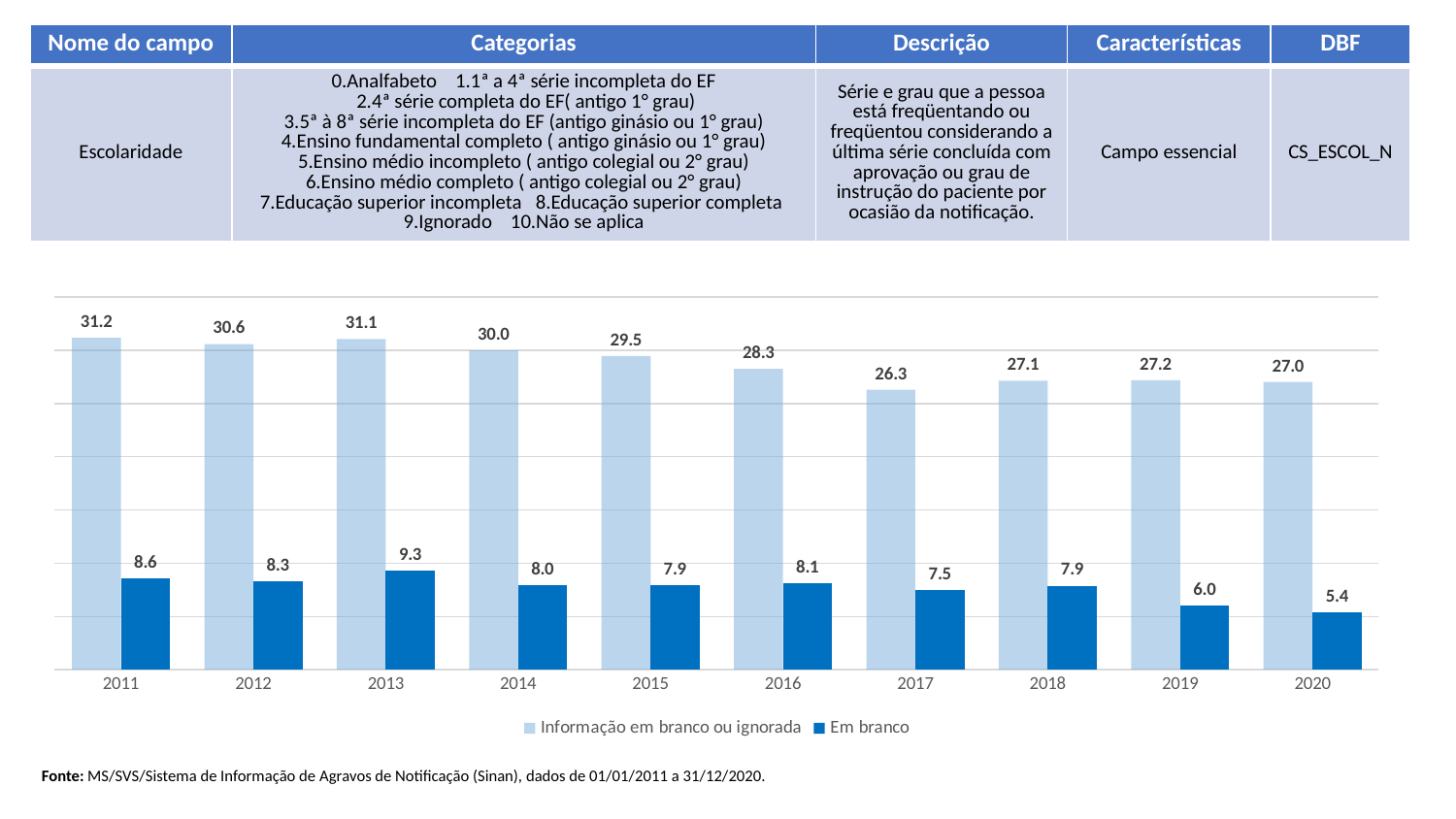
How many series does the legend list? 2 What is the value for "Informação em branco ou ignorada" in 2011? 31.2 In which year is the "Informação em branco ou ignorada" series lowest? 2017 What is the difference between the "Em branco" values for 2019 and 2020? 0.6 What is the value for "Em branco" in 2016? 8.1 What kind of chart is shown on the slide? Bar chart In which year is the "Em branco" series lowest? 2020 What is the value for "Em branco" in 2020? 5.4 How many years are shown on the x axis? 10 In which year is the "Em branco" series highest? 2013 What is the difference between the "Informação em branco ou ignorada" value and the "Em branco" value in 2011? 22.6 Which is larger: the "Informação em branco ou ignorada" value in 2018 or in 2016? 2016